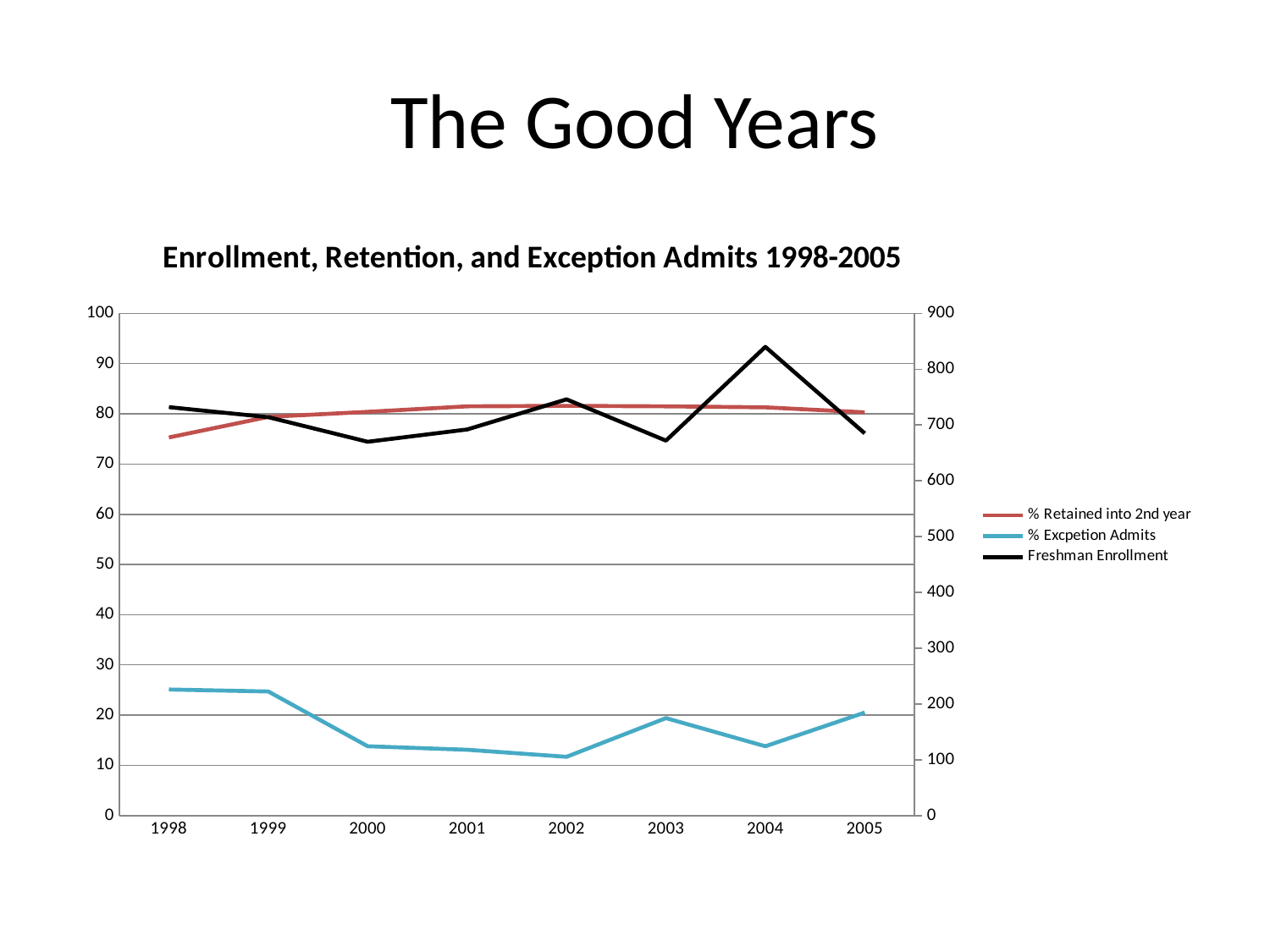
In which year is Freshman Enrollment highest? 2004 How many years are plotted along the x axis? 8 What kind of chart is shown on the slide? line chart Is the Freshman Enrollment value for 2004 greater or less than 800 on the right axis? greater How many series does the legend list? 3 Is the % Retained into 2nd year value for 1998 greater or less than 80? less In which year is % Excpetion Admits lowest? 2002 What is the title of the chart? Enrollment, Retention, and Exception Admits 1998-2005 Does % Excpetion Admits rise or fall from 1998 to 2002? fall In which year is % Retained into 2nd year lowest? 1998 Which series is drawn with the black line? Freshman Enrollment Is the % Excpetion Admits value for 2002 greater or less than 20? less